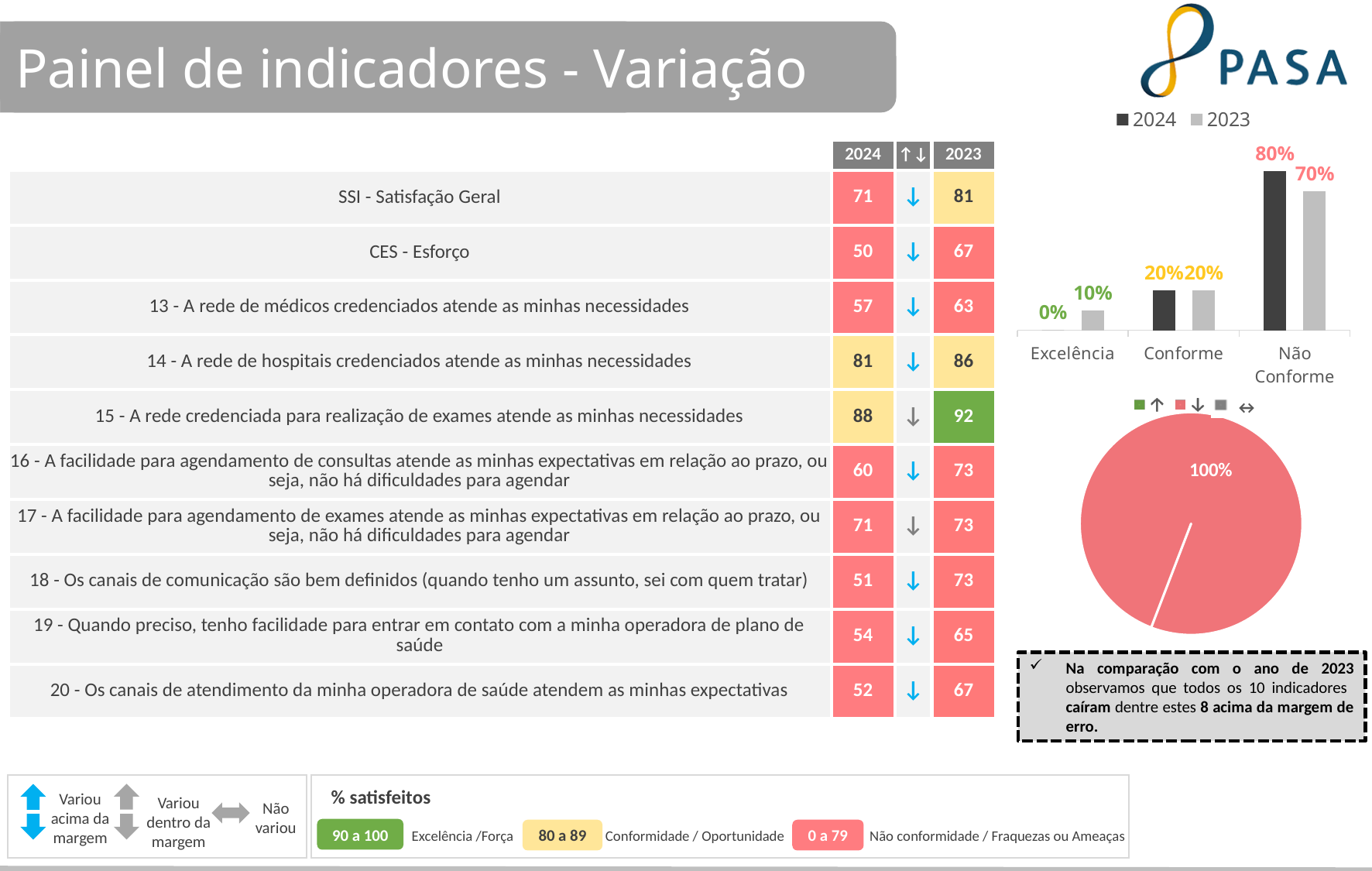
What type of chart is shown at the top right of the slide? bar chart In the bar chart at the top right, what is the 2023 value for Não Conforme? 70% In the bar chart at the top right, is the 2024 value for Excelência larger or smaller than the 2023 value for Excelência? smaller How many series does the legend of the bar chart at the top right list? 2 In the bar chart at the top right, which category has the lowest 2023 value? Excelência In the bar chart at the top right, what is the difference between the 2024 and 2023 values for Não Conforme? 10% In the bar chart at the top right, which category has the highest 2024 value? Não Conforme How many categories are shown in the bar chart at the top right? 3 In the bar chart at the top right, what is the 2024 value for Conforme? 20% In the bar chart at the top right, what is the 2023 value for Excelência? 10% In the pie chart, what share is shown for the single slice? 100% In the bar chart at the top right, what is the 2024 value for Não Conforme? 80%